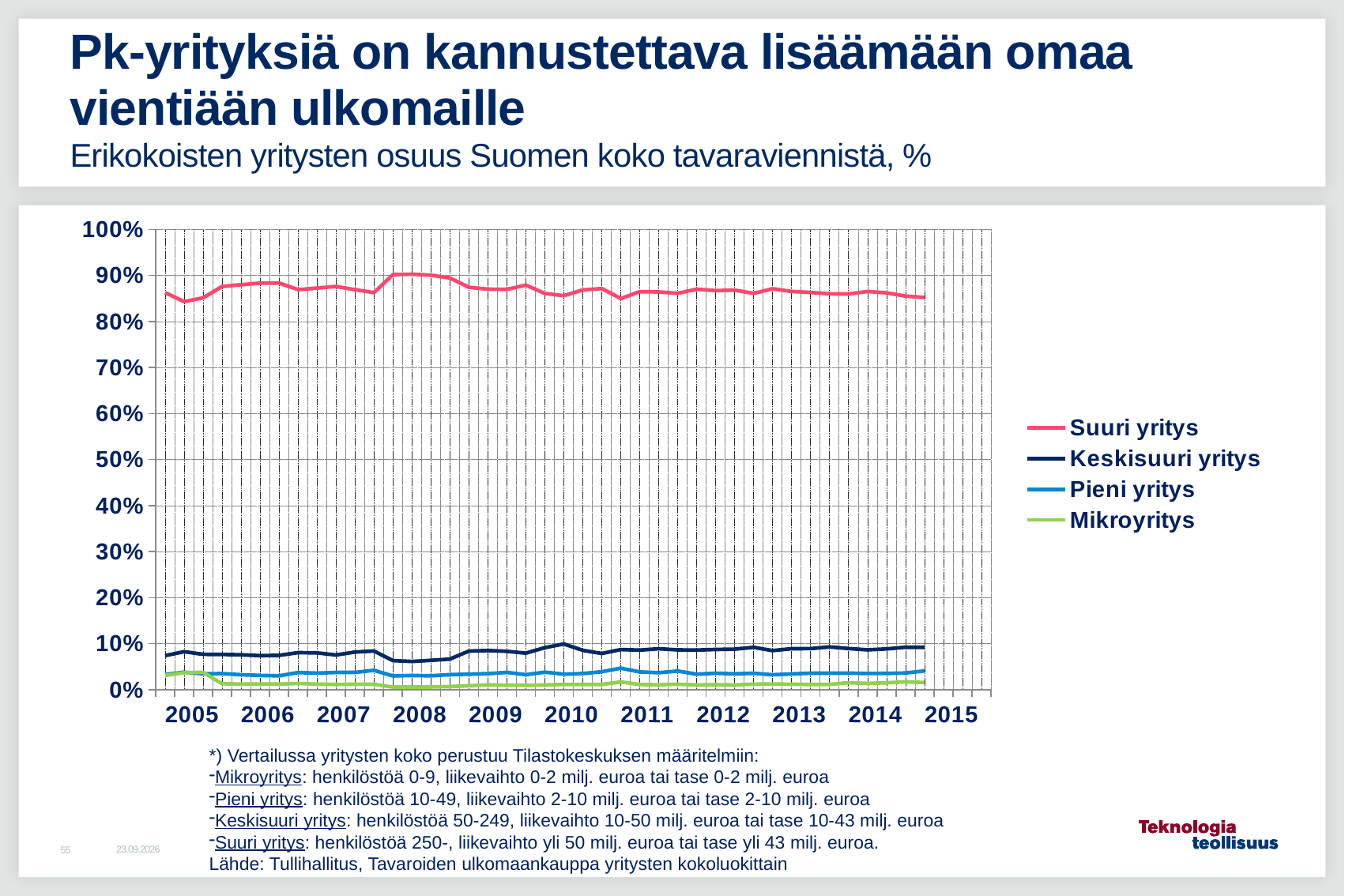
Is the value for Pieni yritys in 2012 greater or less than 10%? less Is the value for Suuri yritys in 2005 greater or less than 50%? greater What colour is the line for Suuri yritys? red How many series does the legend list? 4 Which is larger in 2009, the value for Suuri yritys or the value for Mikroyritys? Suuri yritys How many year labels are shown on the x axis? 11 What kind of chart is shown on the slide? line chart Is the value for Keskisuuri yritys in 2010 greater or less than 20%? less Which is larger in 2013, the value for Keskisuuri yritys or the value for Pieni yritys? Keskisuuri yritys Which series has the highest share of Finland's goods exports throughout the period? Suuri yritys